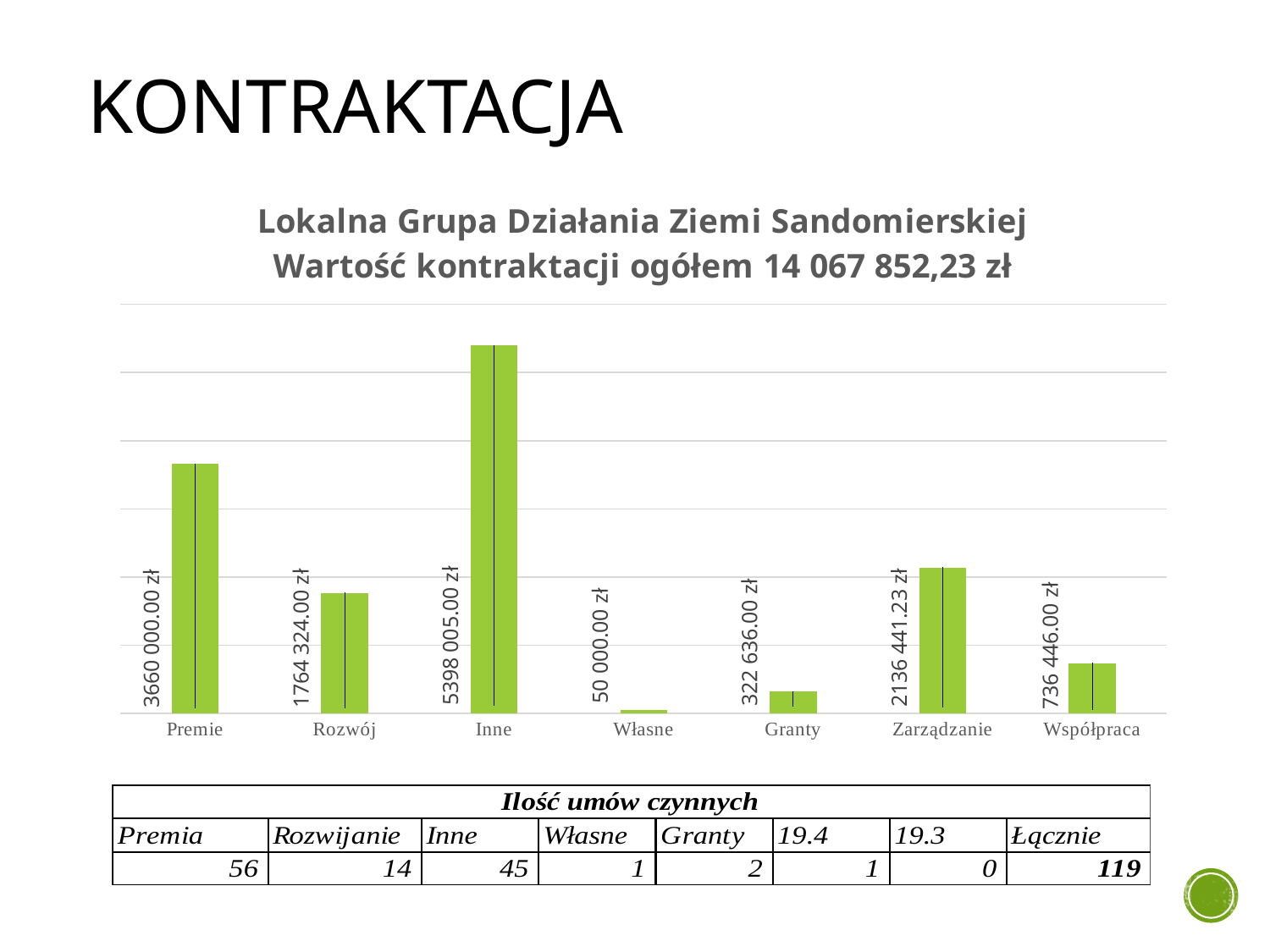
What is the value for Zarządzanie? 2136 441.23 zł What is the value for Inne? 5398 005.00 zł How many categories are shown on the chart? 7 Which category has the lowest value? Własne What is the value for Współpraca? 736 446.00 zł Which is larger, the value for Rozwój or the value for Zarządzanie? Zarządzanie Which category has the highest value? Inne What kind of chart is shown on the slide? bar chart What is the value for Granty? 322 636.00 zł What total contract value (Wartość kontraktacji ogółem) is stated in the chart title? 14 067 852,23 zł What is the difference between the values for Inne and Premie? 1738 005.00 zł What is the value for Premie? 3660 000.00 zł